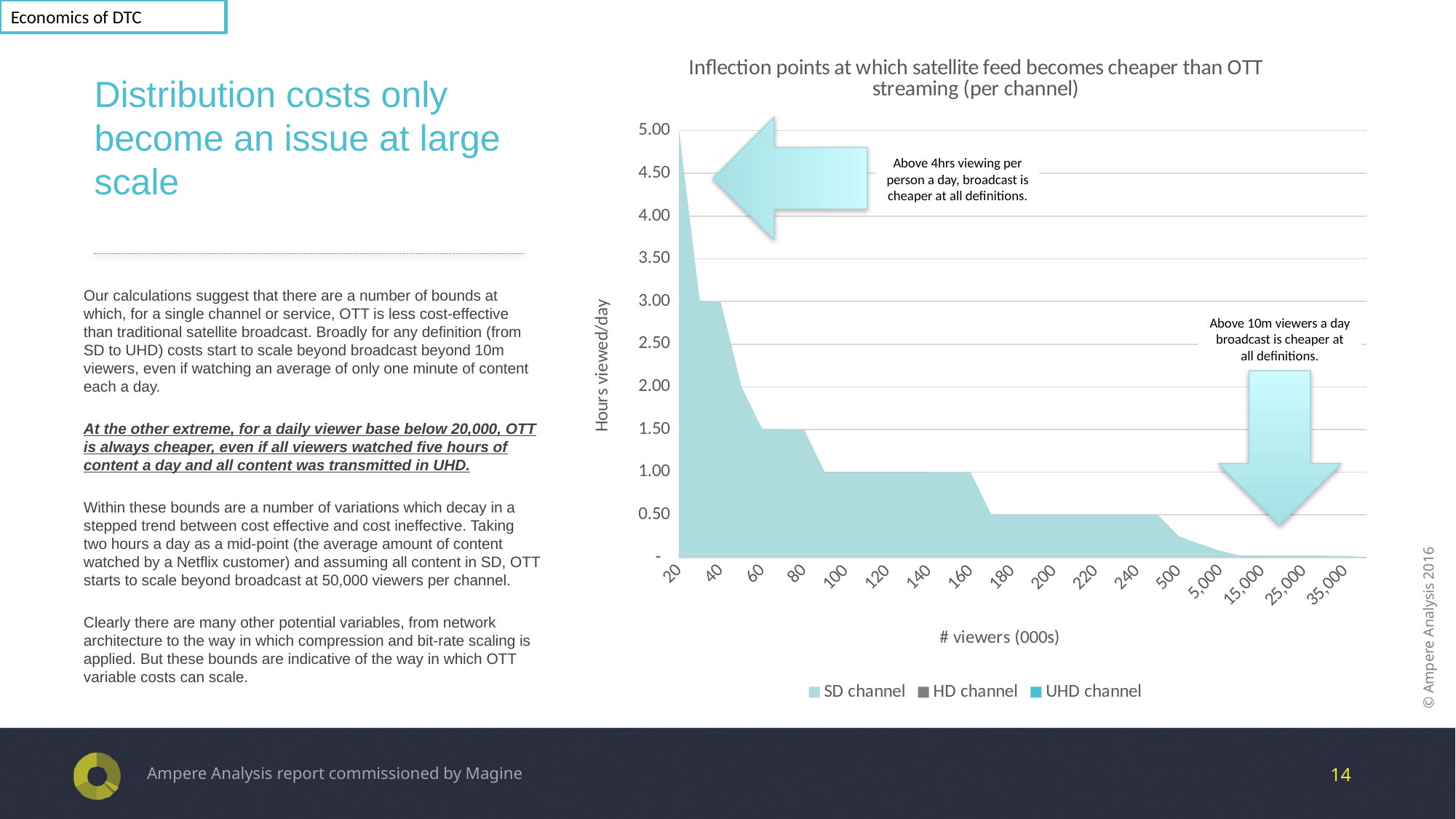
Is the value at 500 thousand viewers greater or less than 0.50? less What is the value (hours viewed/day) at 100 thousand viewers? 1.00 Which is larger, the value at 40 thousand viewers or the value at 160 thousand viewers? 40 At which number of viewers is the hours viewed/day value highest? 20 How many series does the chart legend list? 3 What kind of chart is shown on the slide? area chart What is the title of the chart? Inflection points at which satellite feed becomes cheaper than OTT streaming (per channel) Do the values rise or fall as the number of viewers increases along the x axis? fall What is the label of the y axis? Hours viewed/day What is the value (hours viewed/day) at 20 thousand viewers? 5.00 What is the value (hours viewed/day) at 200 thousand viewers? 0.50